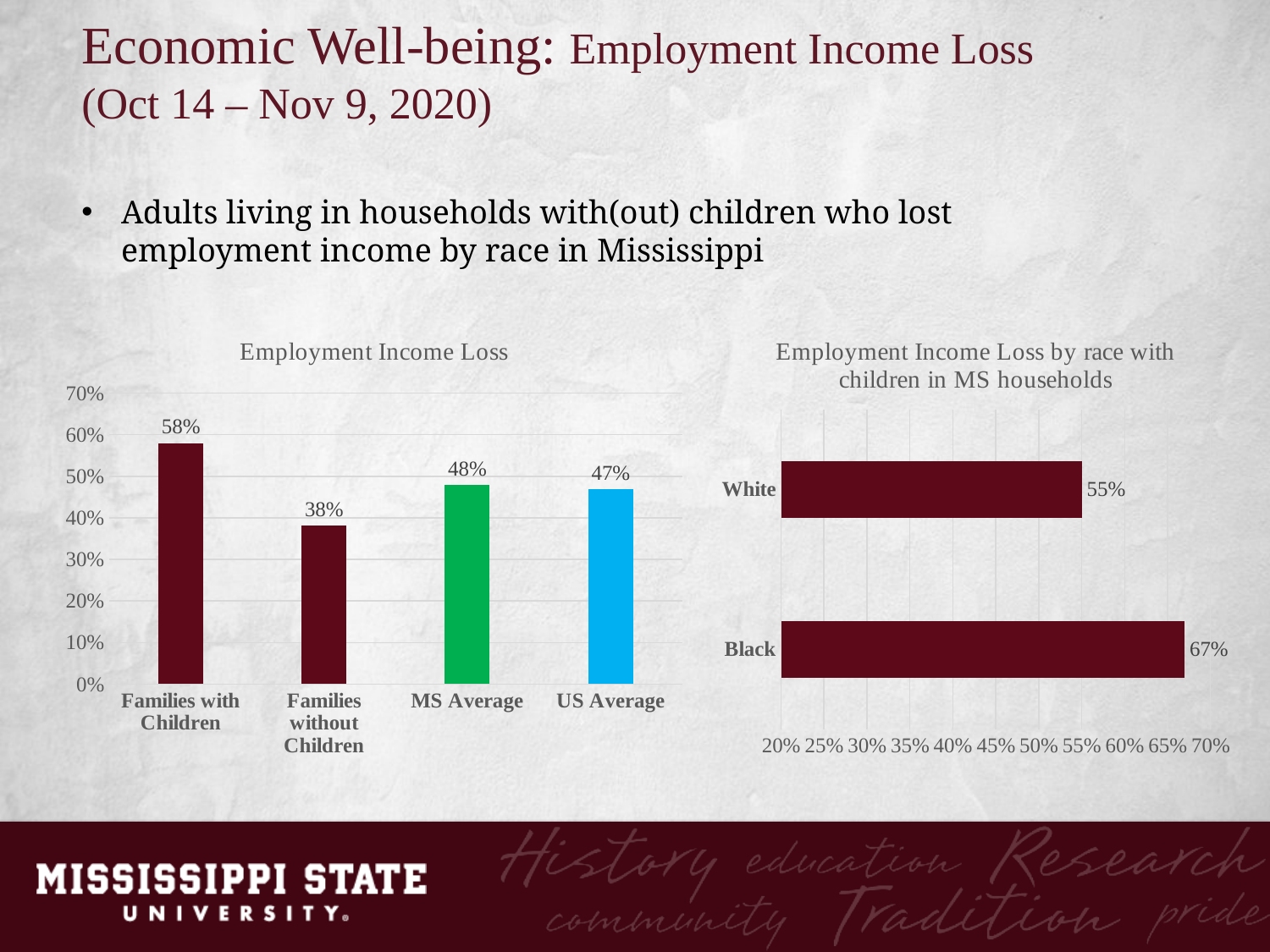
In the 'Employment Income Loss' chart, how many categories are shown? 4 In the 'Employment Income Loss' chart, what is the value for Families without Children? 38% In the 'Employment Income Loss' chart, what colour is the MS Average bar? Green In the 'Employment Income Loss by race with children in MS households' chart, what is the difference between Black and White? 12% In the 'Employment Income Loss by race with children in MS households' chart, what is the value for Black? 67% In the 'Employment Income Loss' chart, what is the value for Families with Children? 58% In the 'Employment Income Loss' chart, what is the value for US Average? 47% In the 'Employment Income Loss' chart, which category has the highest value? Families with Children In the 'Employment Income Loss' chart, which category has the lowest value? Families without Children In the 'Employment Income Loss by race with children in MS households' chart, what is the value for White? 55% In the 'Employment Income Loss' chart, what is the difference between Families with Children and Families without Children? 20% What kind of chart is the 'Employment Income Loss by race with children in MS households' chart? Bar chart